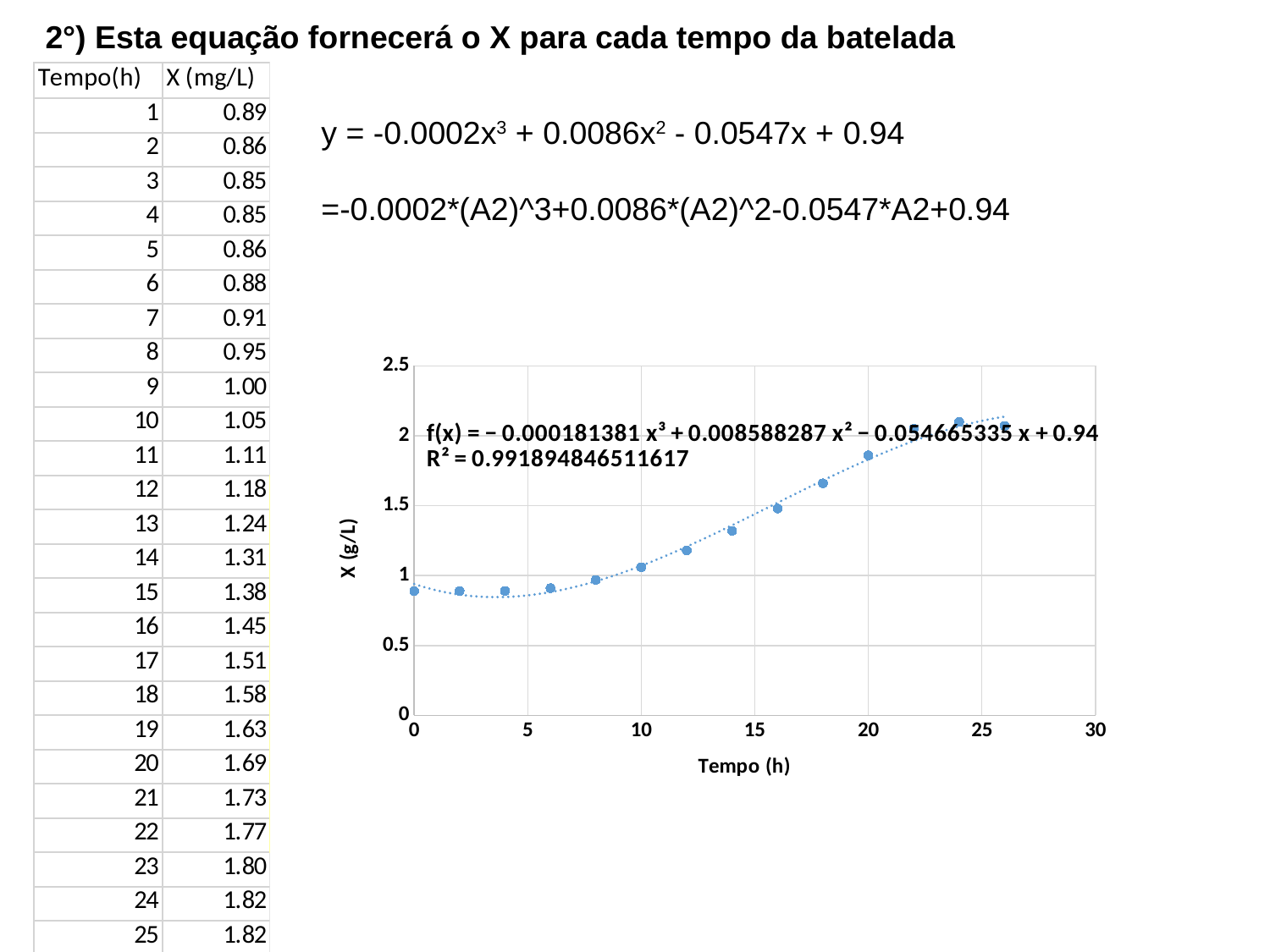
What kind of chart is shown on the slide? Scatter chart Which has a larger X value: the point at Tempo 20 h or the point at Tempo 10 h? Tempo 20 h What is the constant term of the trendline equation f(x) shown on the chart? 0.94 What is the coefficient of x³ in the trendline equation shown on the chart? −0.000181381 What is the title of the horizontal axis of the chart? Tempo (h) What is the maximum value shown on the vertical axis of the chart? 2.5 Do the X values generally rise or fall as Tempo increases from 5 h to 25 h? rise Is the value of X at Tempo 0 h greater or less than 1? less Is the value of X at Tempo 20 h greater or less than 1.5? greater What R² value is displayed on the chart? R² = 0.991894846511617 Is the value of X at Tempo 10 h greater or less than 1.5? less What is the title of the vertical axis of the chart? X (g/L)